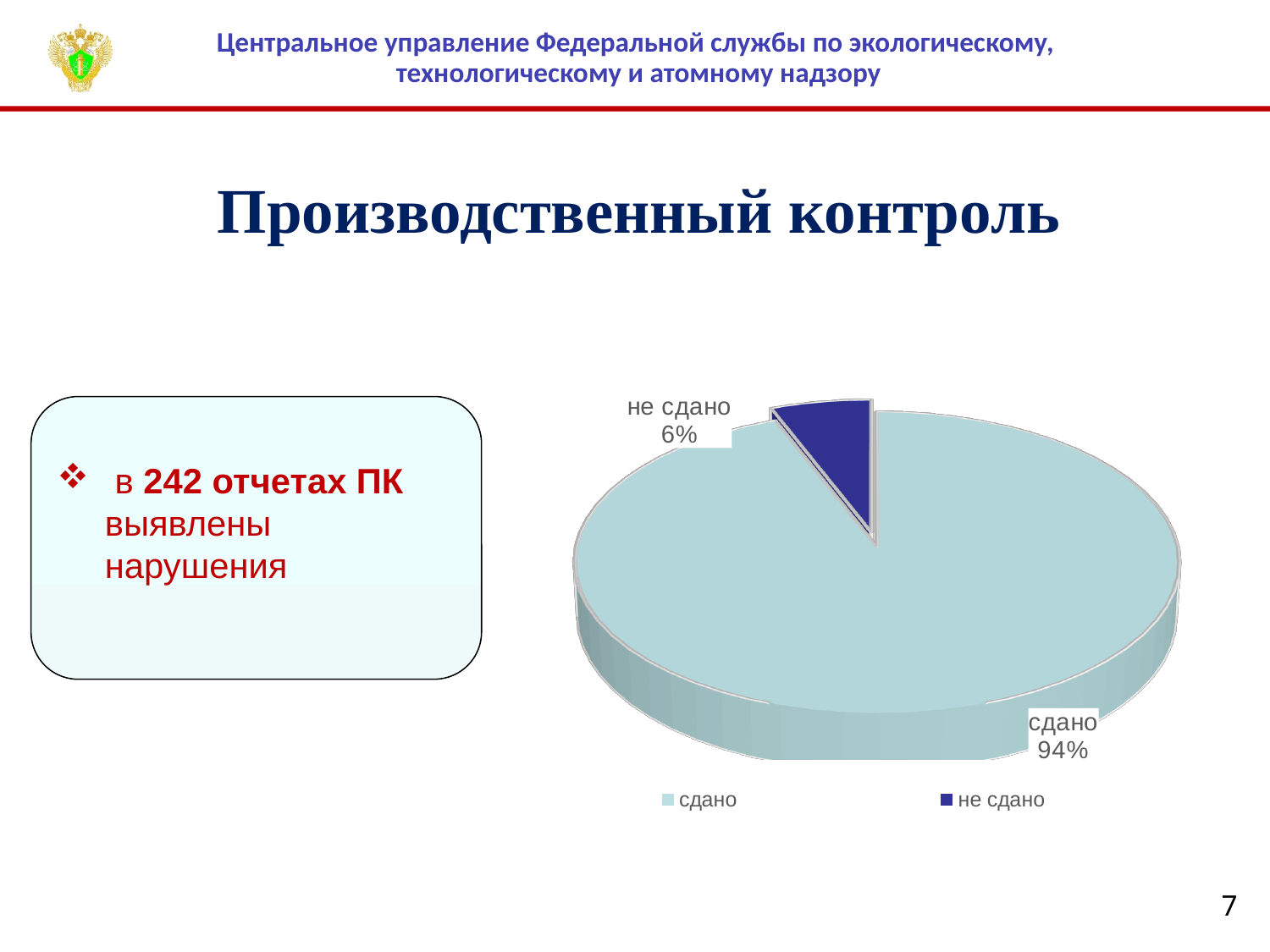
What colour is the "сдано" slice? light blue What share of the pie does the "не сдано" slice represent? 6% Which slice of the pie is the largest? сдано How many slices does the pie chart have? 2 How many entries does the legend list? 2 What colour is the "не сдано" slice? dark blue Which is larger, the "сдано" slice or the "не сдано" slice? сдано What kind of chart is shown on the slide? pie chart What is the difference in percentage points between the "сдано" and "не сдано" slices? 88 What share of the pie does the "сдано" slice represent? 94% Which slice of the pie is the smallest? не сдано